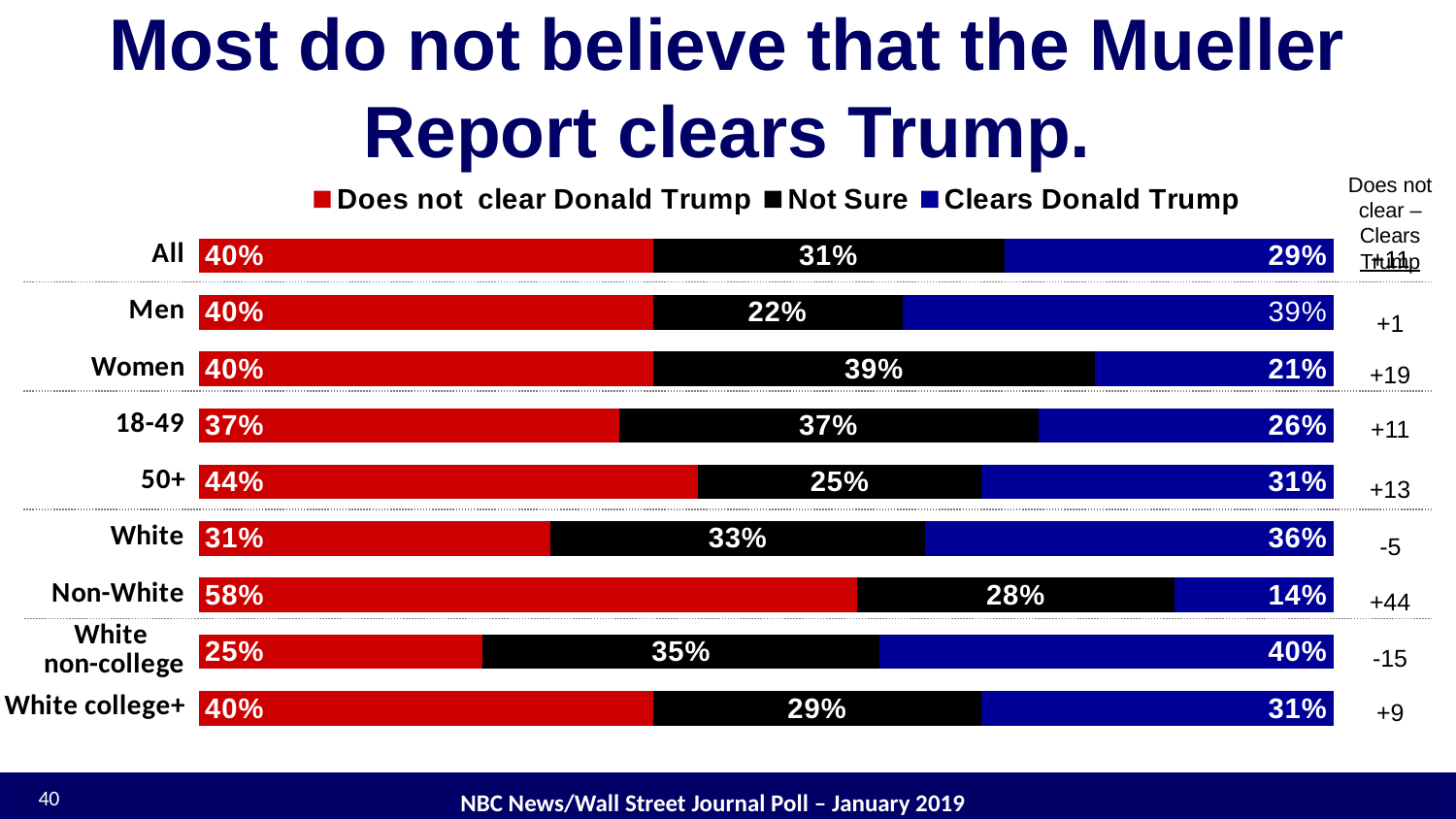
What percentage of Non-White respondents say the Mueller Report does not clear Donald Trump? 58% What is the total of the three segments in the bar for All? 100% Which group has the lowest 'Clears Donald Trump' value? Non-White What is the difference between the 'Does not clear Donald Trump' value for 50+ and for 18-49? 7 percentage points What percentage of White non-college respondents say the report clears Donald Trump? 40% Which colour represents 'Clears Donald Trump' in the chart? Blue What kind of chart is shown on the slide? Stacked bar chart Which group has the highest 'Does not clear Donald Trump' value? Non-White How many groups (categories) are shown in the chart? 9 How many series does the legend list? 3 What is the 'Not Sure' value for Women? 39% Which is larger for Men: the 'Not Sure' value or the 'Clears Donald Trump' value? Clears Donald Trump